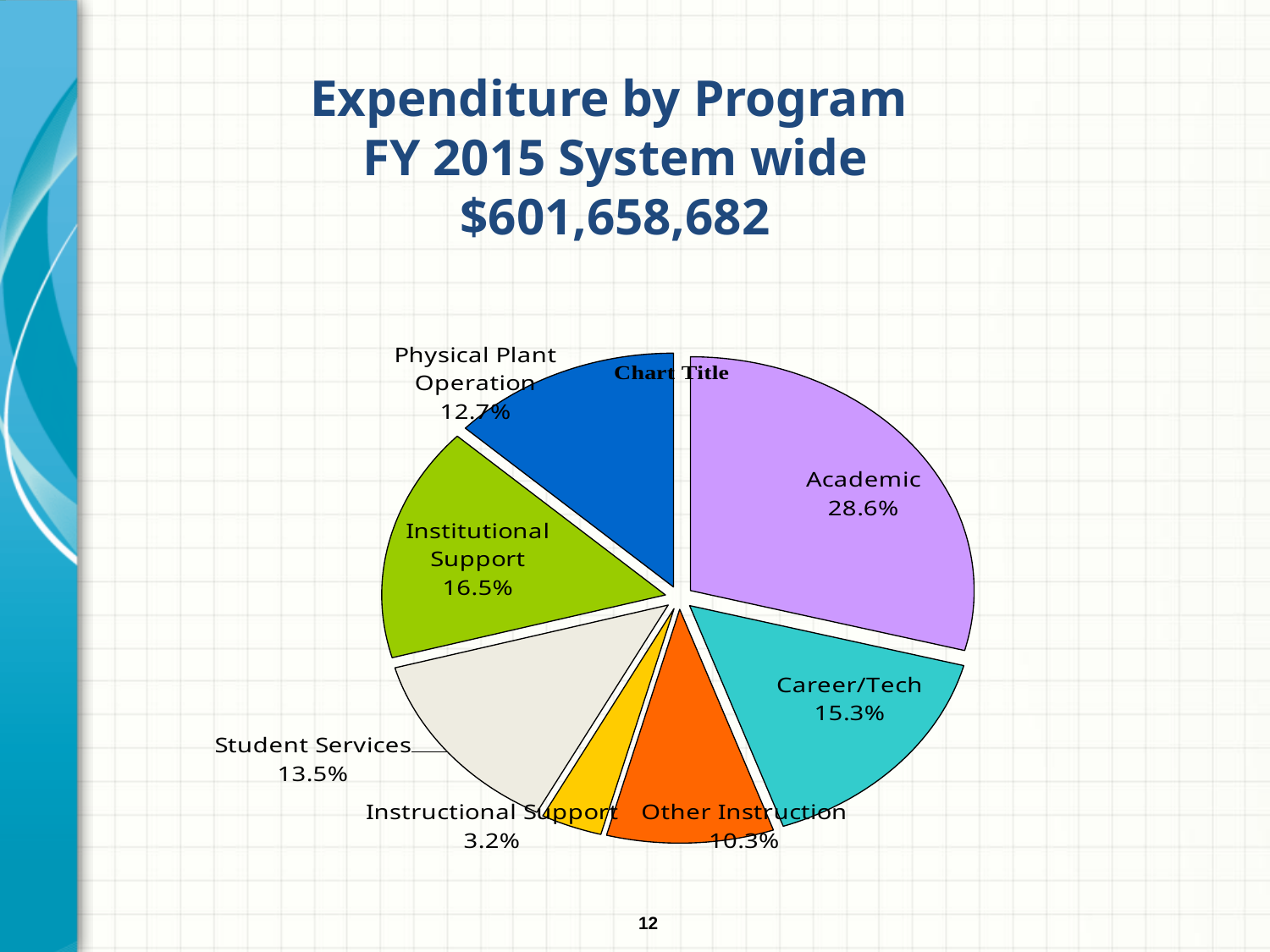
What percentage is shown for Physical Plant Operation? 12.7% What total expenditure amount is given in the slide title? $601,658,682 What percentage is shown for Institutional Support? 16.5% What percentage is shown for Career/Tech? 15.3% What share of expenditure goes to Academic? 28.6% Which program has the largest share of expenditure? Academic What percentage is shown for Instructional Support? 3.2% What kind of chart is shown on the slide? Pie chart Which is larger, Student Services or Other Instruction? Student Services How many slices does the pie chart have? 7 Which program has the smallest share of expenditure? Instructional Support What is the difference in percentage points between Academic and Career/Tech? 13.3